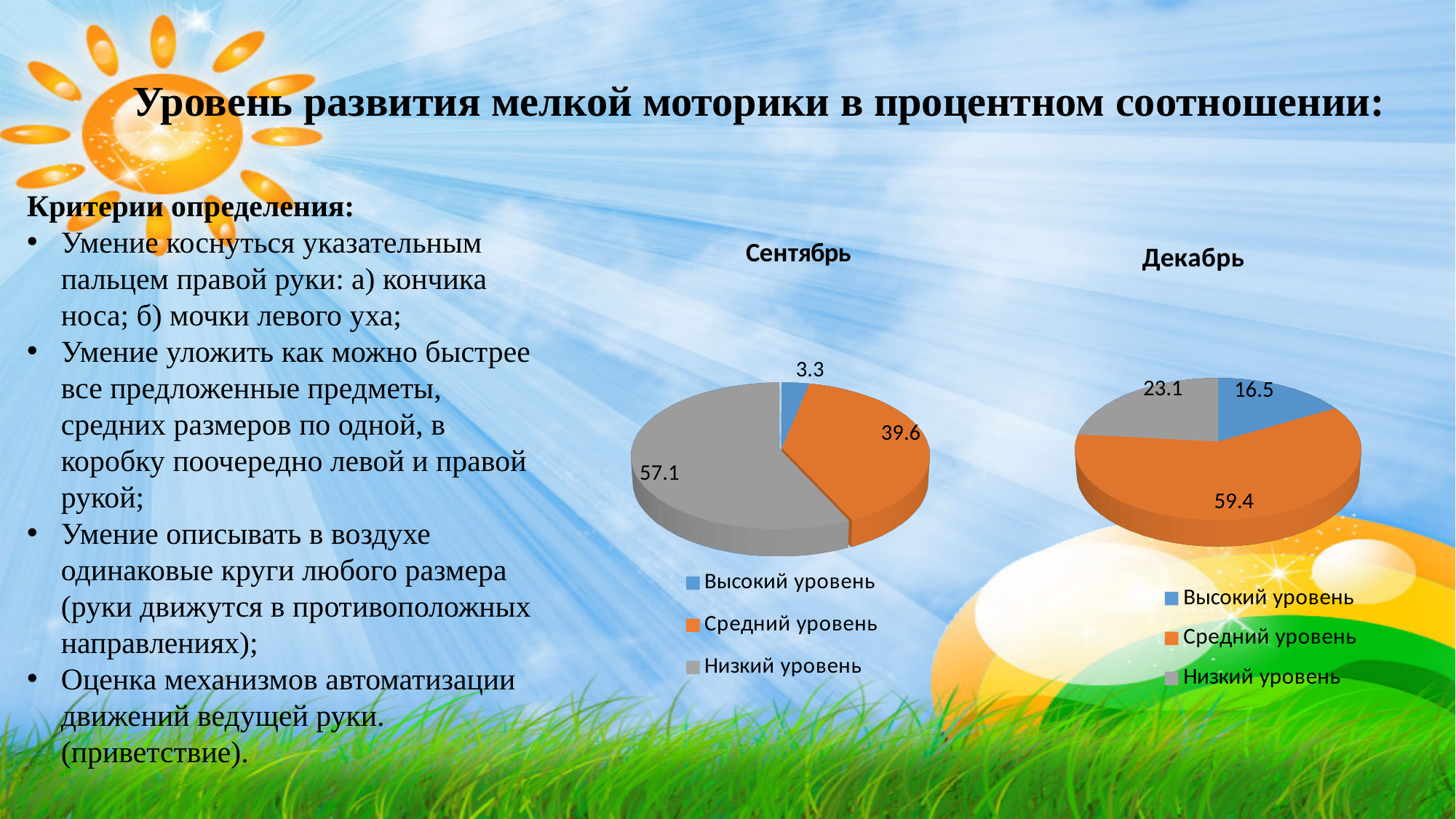
What type of chart is the "Декабрь" chart? Pie chart In the "Сентябрь" chart, what is the value for "Низкий уровень"? 57.1 Which is larger: "Высокий уровень" in the "Сентябрь" chart or "Высокий уровень" in the "Декабрь" chart? Декабрь In the "Декабрь" chart, which category has the smallest slice? Высокий уровень In the "Декабрь" chart, what is the value for "Низкий уровень"? 23.1 In the "Сентябрь" chart, what colour is the "Средний уровень" slice? Orange In the "Декабрь" chart, what is the value for "Средний уровень"? 59.4 In the "Сентябрь" chart, which category has the largest slice? Низкий уровень What is the difference between the "Средний уровень" values in the "Декабрь" chart and the "Сентябрь" chart? 19.8 In the "Сентябрь" chart, what is the value for "Высокий уровень"? 3.3 How many slices does the "Сентябрь" chart have? 3 How many entries does the legend of the "Декабрь" chart list? 3